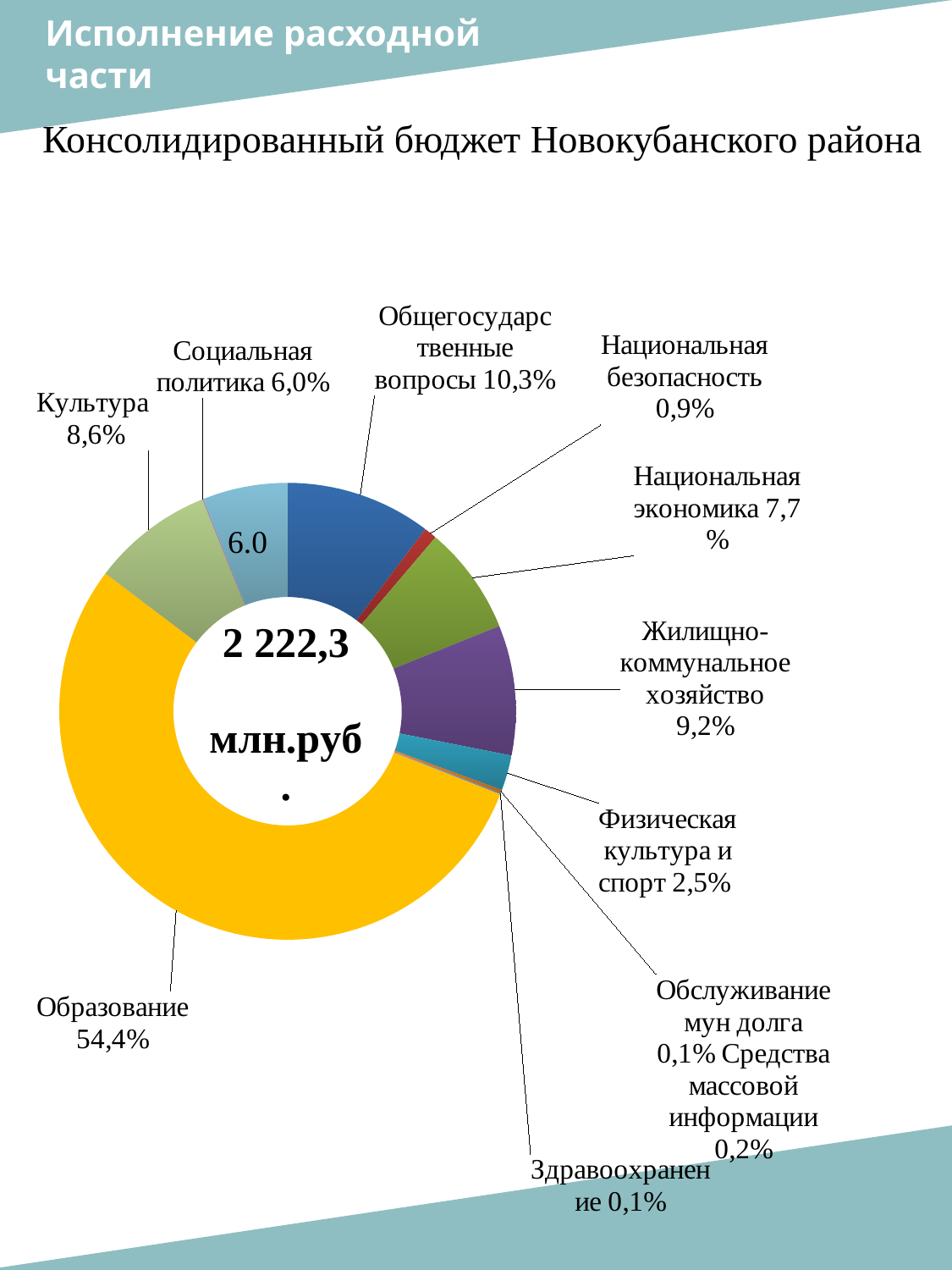
What is the difference in percentage points between Общегосударственные вопросы and Национальная экономика? 2,6 Which has a larger share: Жилищно-коммунальное хозяйство or Культура? Жилищно-коммунальное хозяйство How many categories are shown in the chart? 11 Which category has the largest share of the budget? Образование What share of the budget goes to Общегосударственные вопросы? 10,3% What is the difference in percentage points between Культура and Социальная политика? 2,6 What share of the budget goes to Национальная безопасность? 0,9% What total value is printed in the centre of the chart? 2 222,3 млн.руб. What share of the budget goes to Образование? 54,4% What kind of chart is shown on the slide? Doughnut (pie) chart What share of the budget goes to Жилищно-коммунальное хозяйство? 9,2% Which has a larger share: Физическая культура и спорт or Национальная безопасность? Физическая культура и спорт